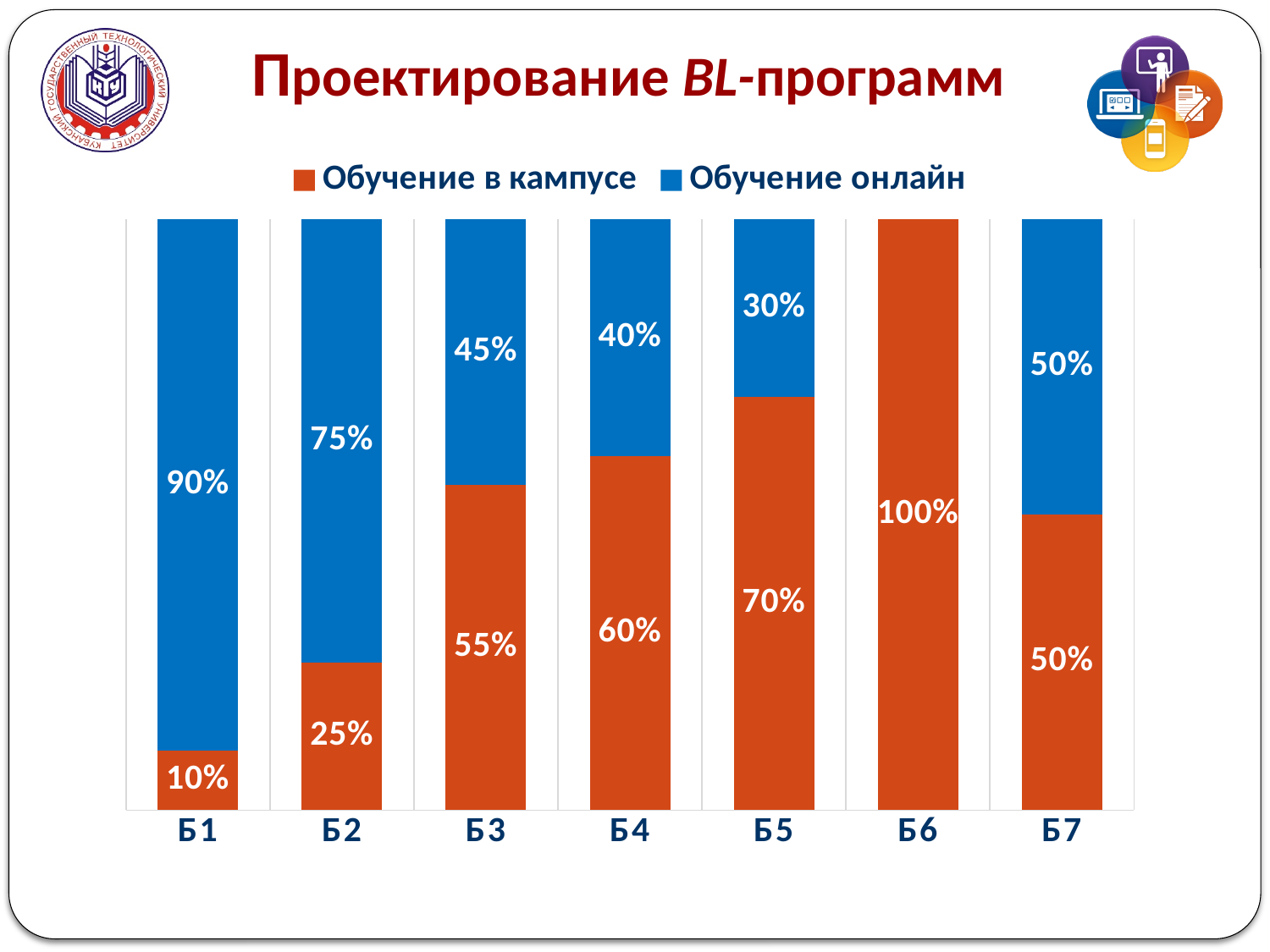
What is the value for "Обучение в кампусе" for Б5? 70% Which is larger: "Обучение в кампусе" for Б3 or "Обучение в кампусе" for Б4? Б4 What is the total of the stacked bar for Б3? 100% Which category has the lowest value for "Обучение в кампусе"? Б1 Which category has the highest value for "Обучение в кампусе"? Б6 What is the value for "Обучение в кампусе" for Б1? 10% What is the value for "Обучение онлайн" for Б7? 50% What is the difference between the "Обучение онлайн" values for Б1 and Б4? 50% What kind of chart is shown on the slide? Stacked bar chart How many series does the legend list? 2 What is the value for "Обучение онлайн" for Б2? 75% How many categories are shown on the x axis? 7